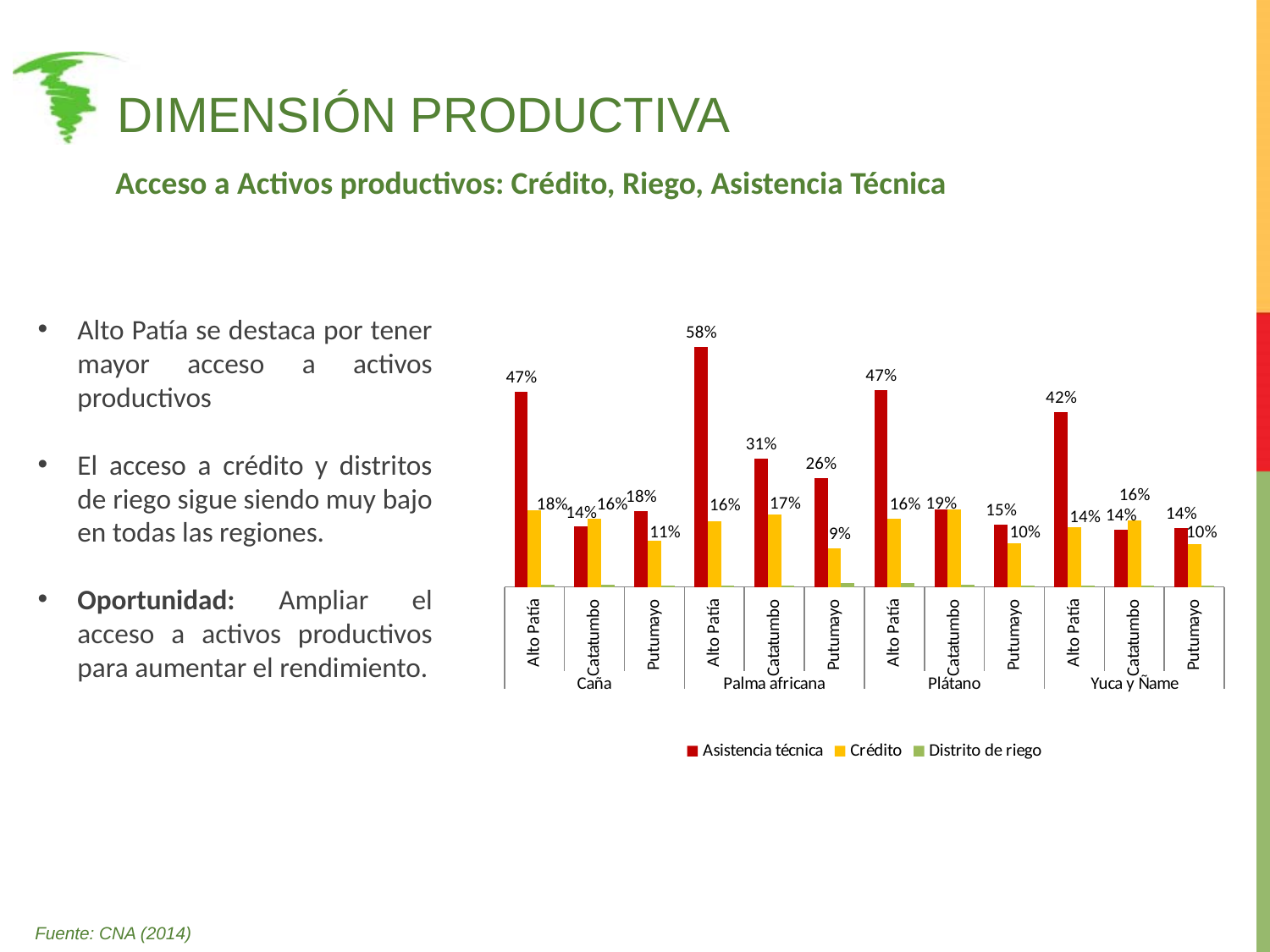
What type of chart is shown on the slide? Bar chart Under Caña, which is larger for Catatumbo: Asistencia técnica or Crédito? Crédito What is the difference between the Asistencia técnica values for Alto Patía and Catatumbo under Palma africana? 27 percentage points What is the Asistencia técnica value for Alto Patía under Palma africana? 58% What is the Crédito value for Putumayo under Palma africana? 9% What is the difference between the Asistencia técnica values for Alto Patía under Caña and under Yuca y Ñame? 5 percentage points What is the Asistencia técnica value for Alto Patía under Yuca y Ñame? 42% How many crop groups are shown on the x axis? 4 What is the Crédito value for Catatumbo under Plátano? 19% Which region and crop has the highest Asistencia técnica value? Alto Patía, Palma africana Which series is shown in red in the legend? Asistencia técnica How many series does the chart legend list? 3